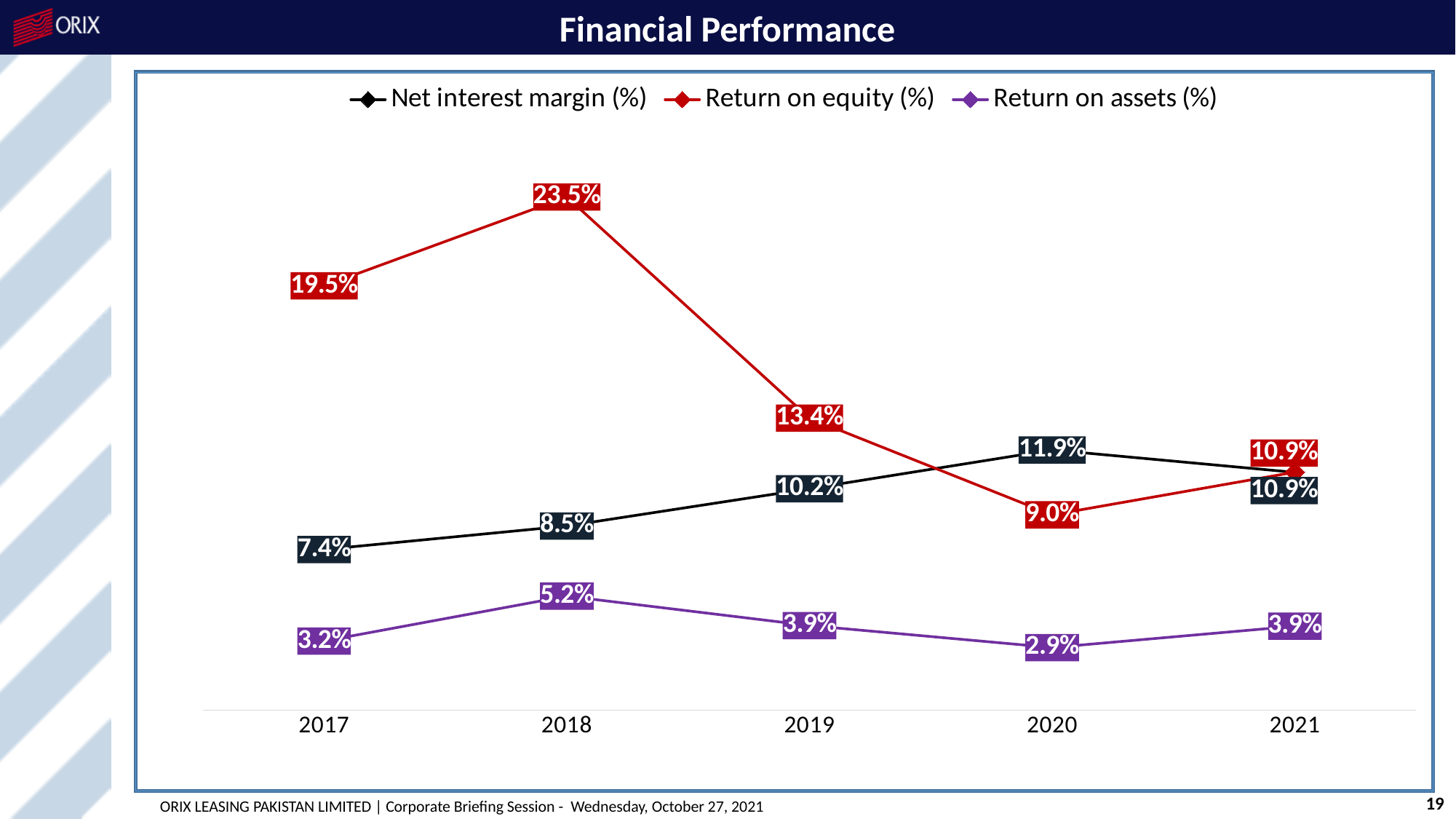
In which year is Net interest margin (%) lowest? 2017 What is the Net interest margin (%) for 2019? 10.2% Which is larger in 2020: Net interest margin (%) or Return on equity (%)? Net interest margin (%) How many years are shown on the x axis? 5 In which year is Return on equity (%) highest? 2018 Does Net interest margin (%) rise or fall from 2017 to 2020? Rise What colour is the Return on assets (%) line? Purple How many series does the legend list? 3 What kind of chart is shown on the slide? Line chart What is the Return on assets (%) for 2020? 2.9% What is the difference between Return on equity (%) in 2017 and 2018? 4.0% What is the Return on equity (%) for 2018? 23.5%